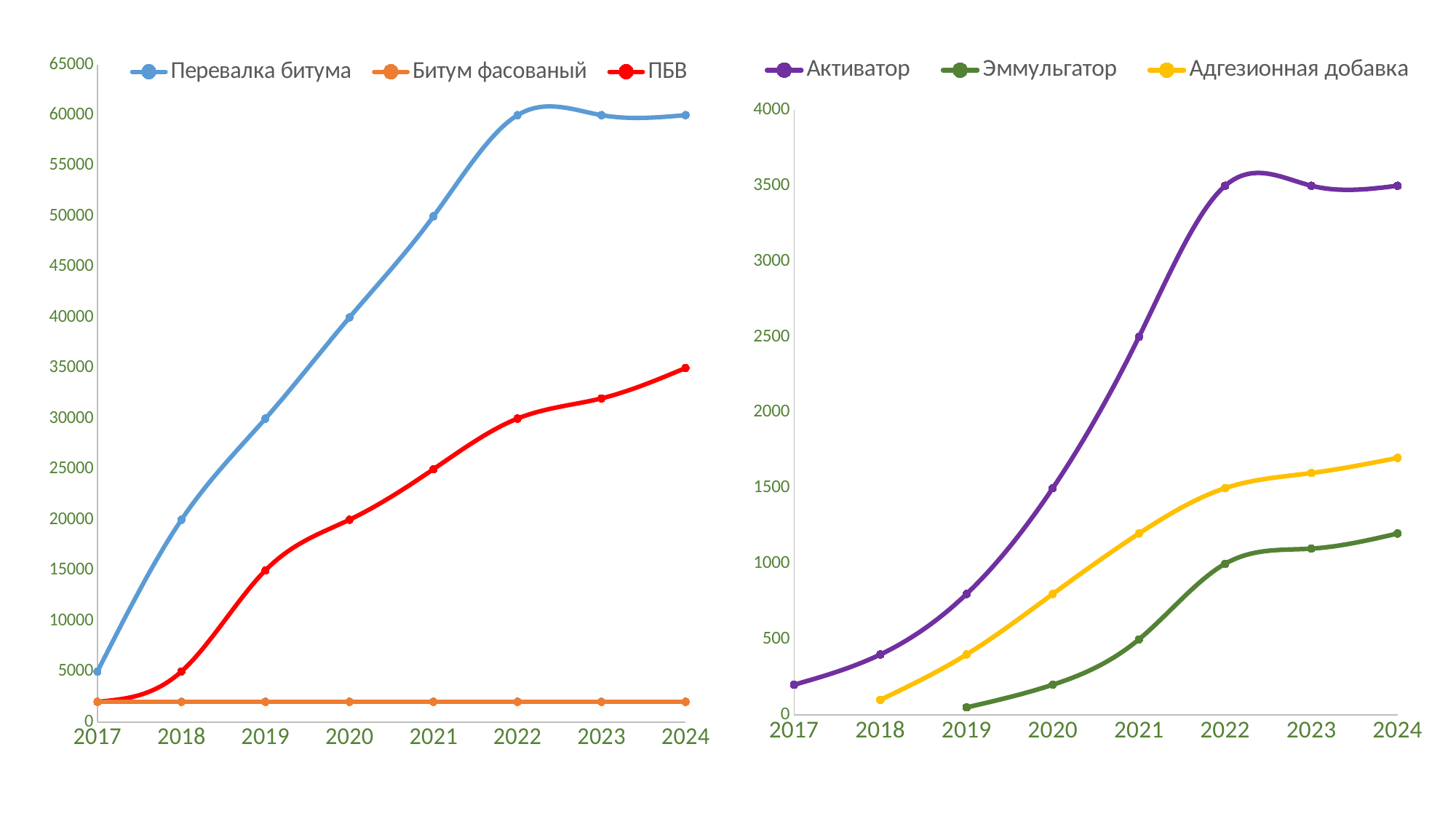
In the right chart, does the Адгезионная добавка series rise or fall from 2018 to 2024? rise In the left chart, is the value for Перевалка битума in 2017 greater or less than 10000? less In the right chart, is the value for Эммульгатор in 2024 greater or less than 1000? greater In the left chart, which series has the highest value in 2024? Перевалка битума In the left chart, which is larger in 2024: ПБВ or Битум фасованый? ПБВ In the left chart, what is the value for Перевалка битума in 2020? 40000 How many years are shown on the x axis of the left chart? 8 What type of chart is the left chart on the slide? line chart How many series does the legend of the right chart list? 3 In the right chart, what is the value for Активатор in 2021? 2500 In the left chart, what is the value for ПБВ in 2022? 30000 In the right chart, which series has the lowest value in 2024? Эммульгатор